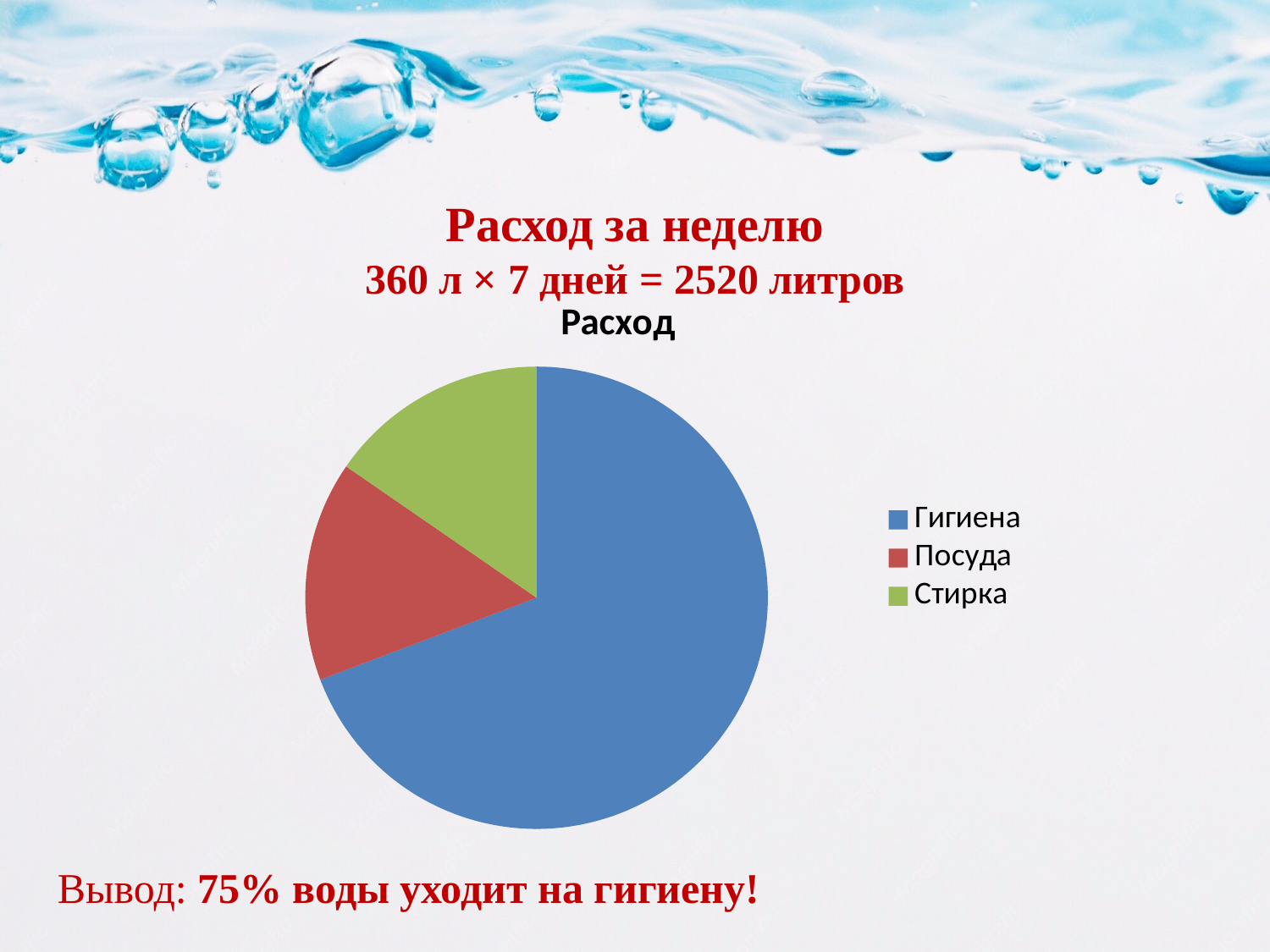
Which category has the largest slice in the pie chart? Гигиена How many entries does the legend of the pie chart list? 3 Which slice is larger, Гигиена or Посуда? Гигиена What is the title of the pie chart? Расход What share of the pie does Гигиена take, according to the slide? 75% How many slices does the pie chart have? 3 Which slice is larger, Гигиена or Стирка? Гигиена What kind of chart is shown on the slide? pie chart What colour is the Стирка slice in the pie chart? green